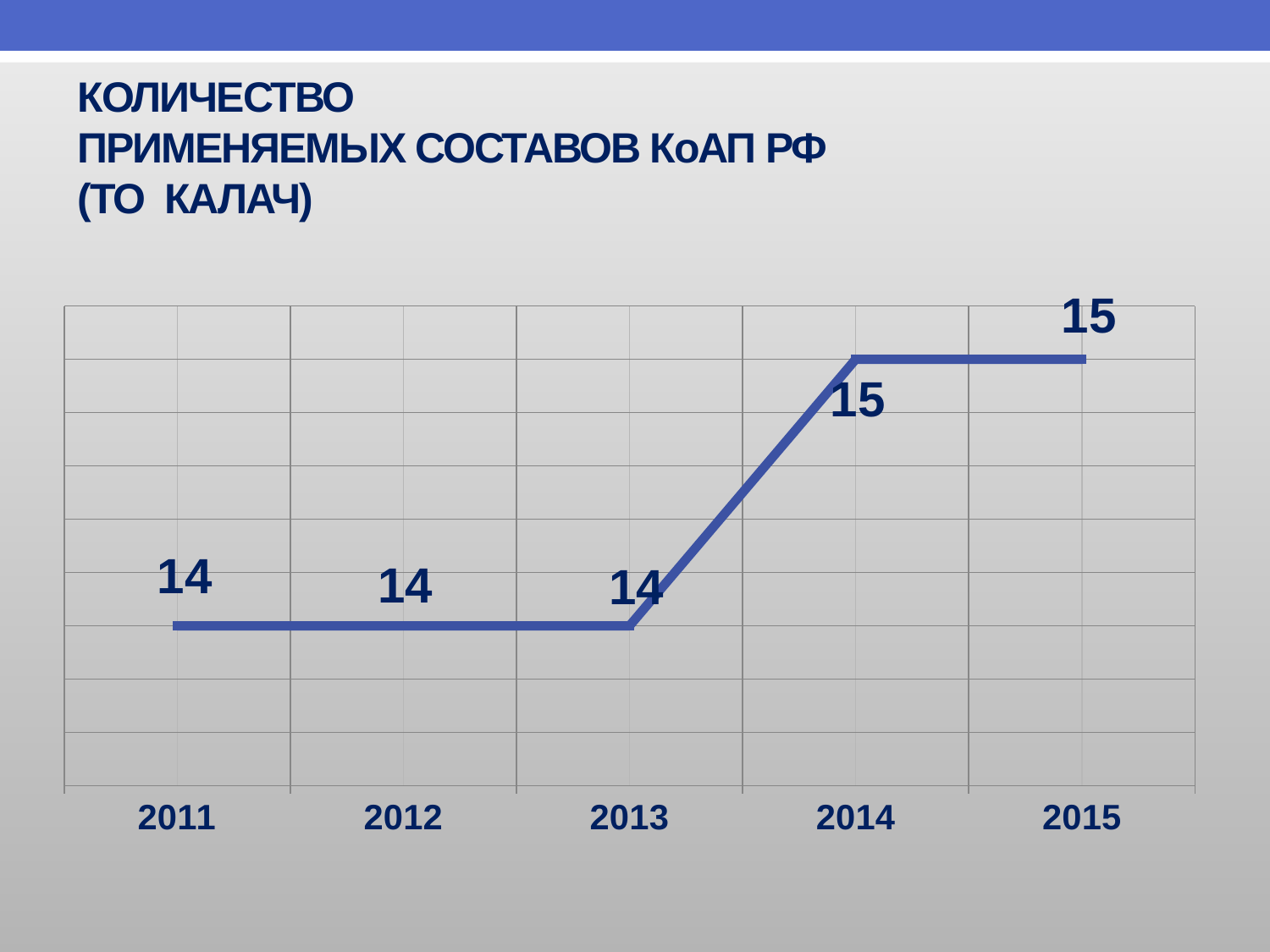
What is the value for 2011? 14 In which year does the value first reach 15? 2014 What is the difference between the values for 2014 and 2013? 1 Do the values rise or fall from 2013 to 2014? rise What is the value for 2015? 15 What is the value for 2014? 15 What is the first year shown on the x axis? 2011 What kind of chart is shown on the slide? line chart How many years are plotted on the chart? 5 What is the value for 2013? 14 Which is larger, the value for 2012 or the value for 2015? 2015